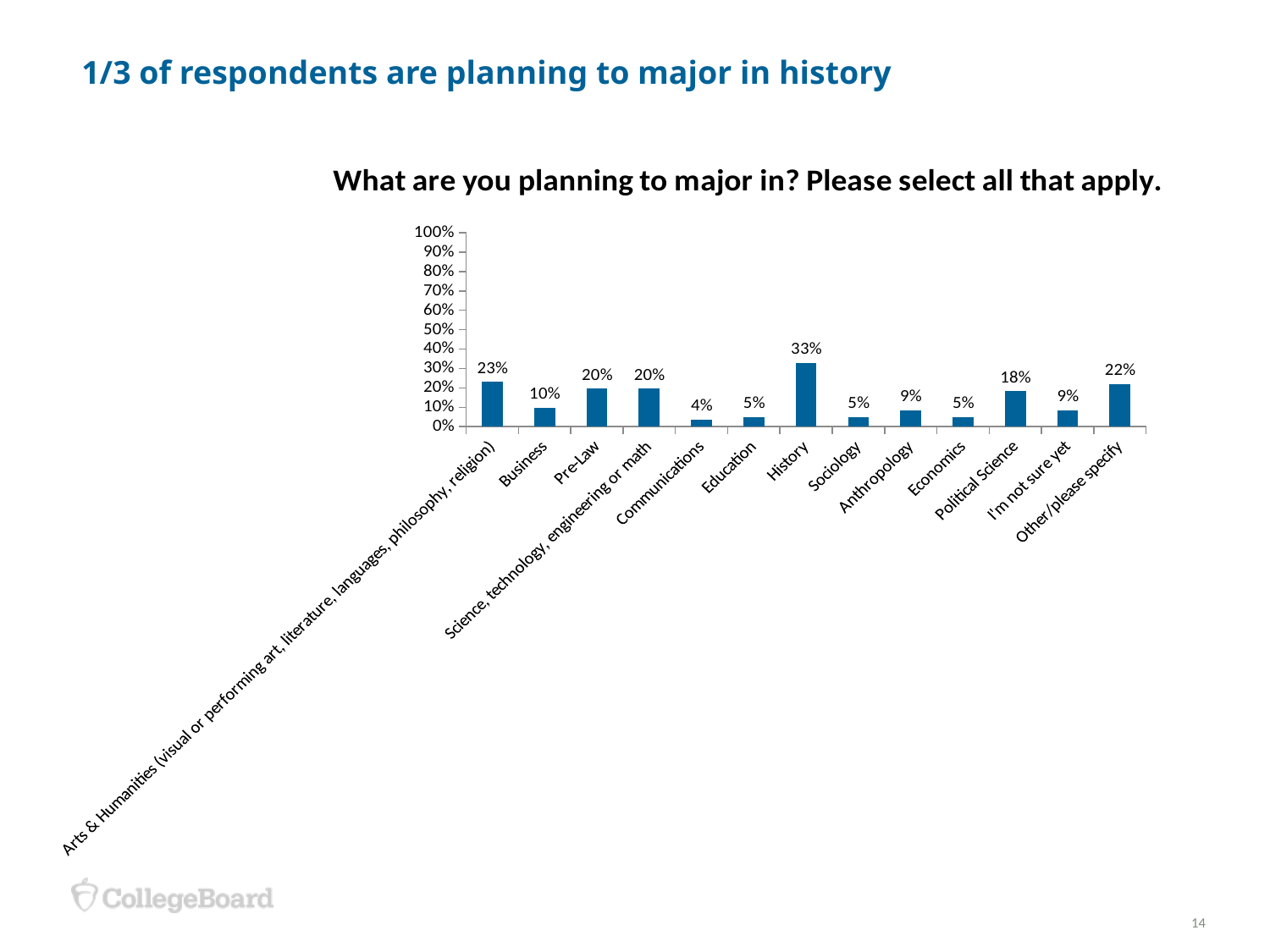
What is the difference in percentage points between History and Other/please specify? 11% What is the difference in percentage points between Pre-Law and Education? 15% What percentage of respondents are planning to major in Political Science? 18% What is the title of the chart? What are you planning to major in? Please select all that apply. Which planned major has the highest percentage of respondents? History What kind of chart is shown on the slide? Bar chart Which planned major has the lowest percentage of respondents? Communications What percentage of respondents are planning to major in History? 33% Which has a higher percentage of respondents, Arts & Humanities or Political Science? Arts & Humanities How many planned major categories are shown on the chart? 13 Is the value for History greater or less than 30%? greater What percentage of respondents selected Business as a planned major? 10%